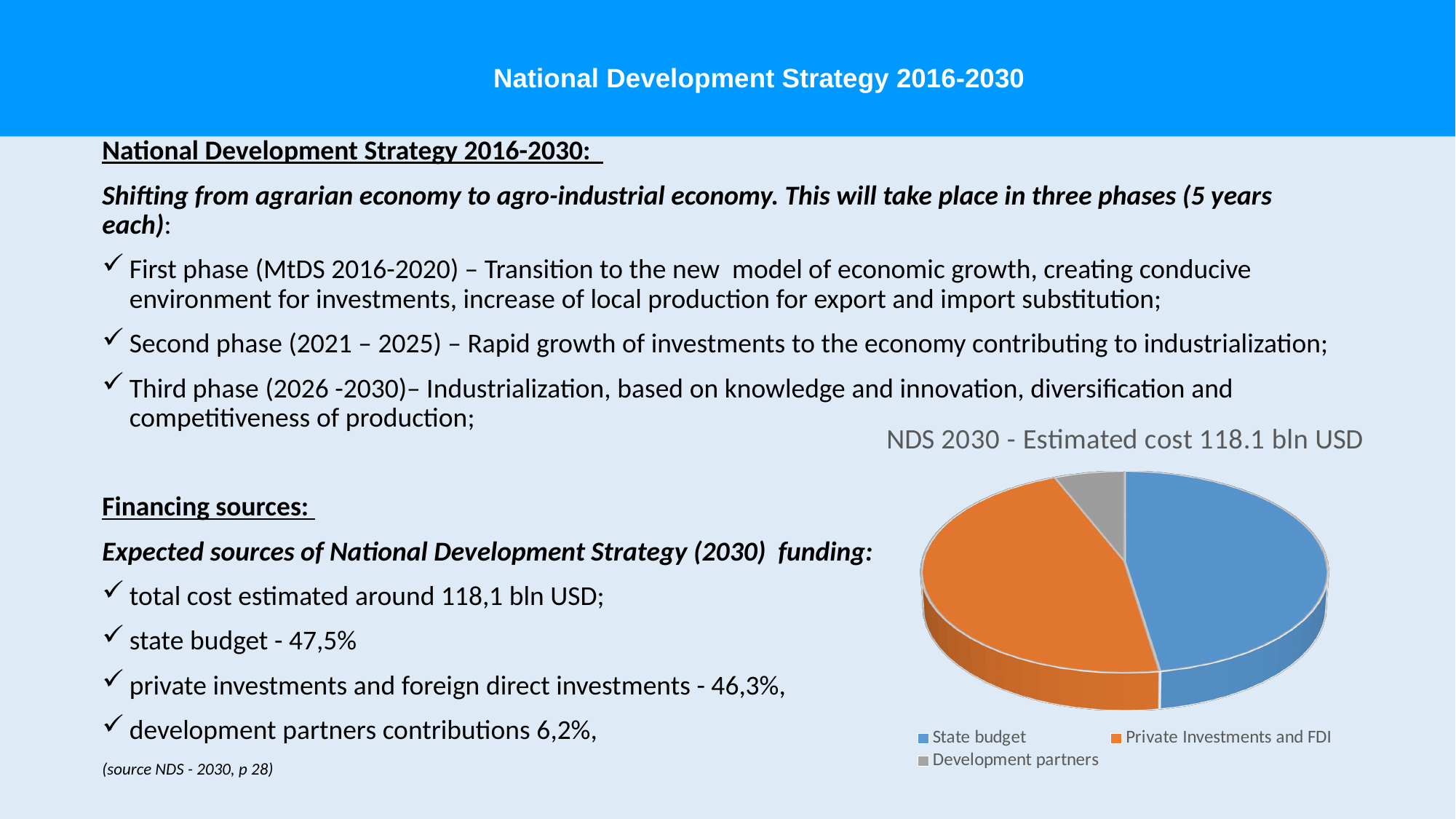
Which slice of the pie chart is the largest? State budget What colour is the Private Investments and FDI slice in the pie chart? orange How many entries does the pie chart's legend list? 3 What share of the pie does Private Investments and FDI represent? 46,3% Which is larger in the pie chart: State budget or Development partners? State budget How many slices does the pie chart have? 3 What kind of chart is shown on the slide? pie chart What share of the pie does Development partners represent? 6,2% Which slice of the pie chart is the smallest? Development partners What share of the pie does State budget represent? 47,5% What is the title of the pie chart? NDS 2030 - Estimated cost 118.1 bln USD Is the State budget slice greater or less than half of the pie? less